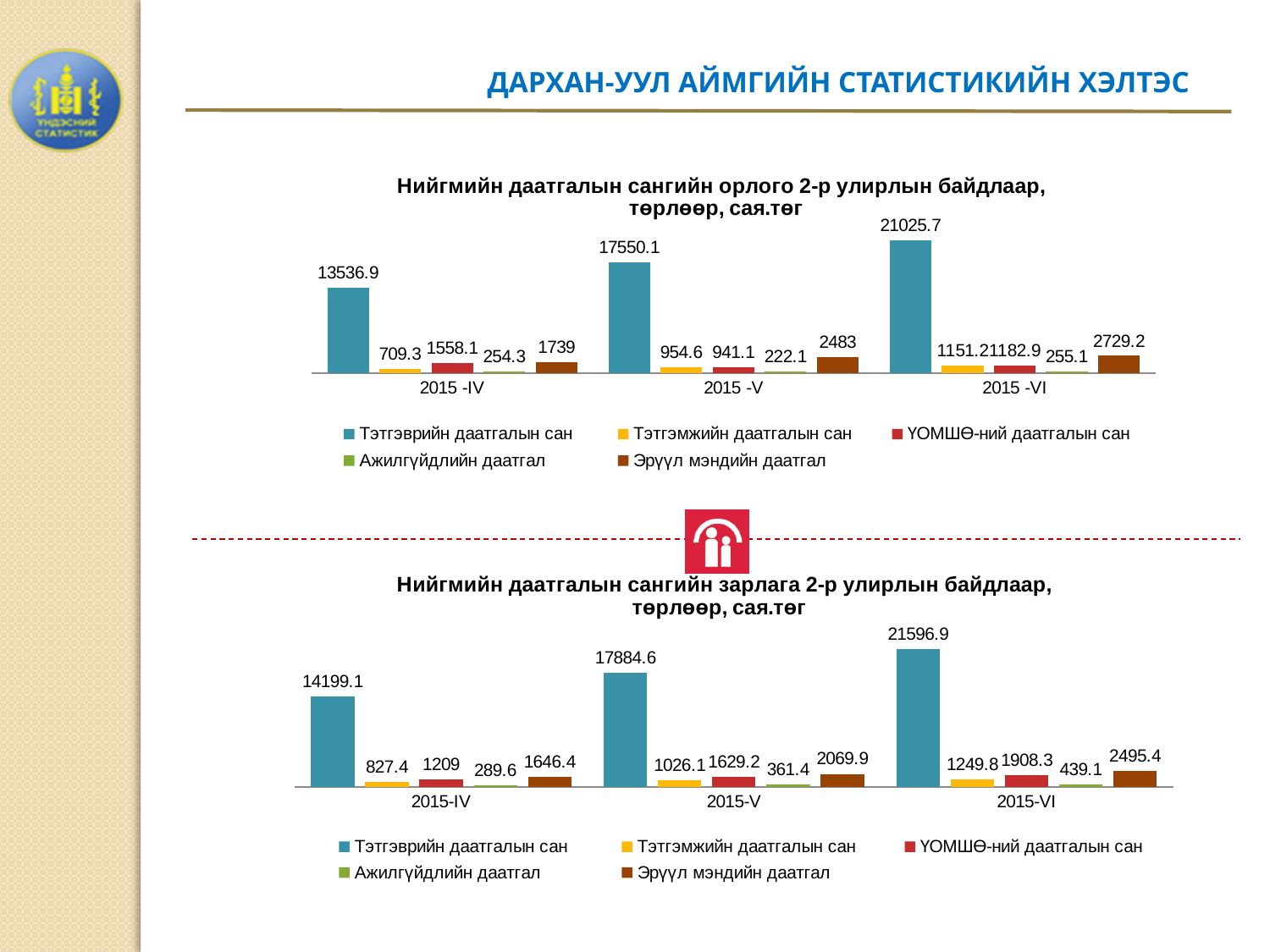
How many periods are shown on the x axis of the top chart (income)? 3 In the top chart (income), what is the value of Эрүүл мэндийн даатгал for 2015 -V? 2483 In the bottom chart (expenditure), what is the value of ҮОМШӨ-ний даатгалын сан for 2015-VI? 1908.3 In the top chart (income), what is the value of Тэтгэврийн даатгалын сан for 2015 -VI? 21025.7 What type of chart is the top chart (income)? Bar chart In the bottom chart (expenditure), does the value of Эрүүл мэндийн даатгал rise or fall from 2015-IV to 2015-VI? Rise In the bottom chart (expenditure), which period has the lowest value for Тэтгэмжийн даатгалын сан? 2015-IV In the bottom chart (expenditure), which is larger for 2015-V: Тэтгэмжийн даатгалын сан or ҮОМШӨ-ний даатгалын сан? ҮОМШӨ-ний даатгалын сан In the bottom chart (expenditure), what is the value of Ажилгүйдлийн даатгал for 2015-IV? 289.6 How many series does the legend of the bottom chart (expenditure) list? 5 In the top chart (income), which period has the highest value for Тэтгэврийн даатгалын сан? 2015 -VI In the top chart (income), what is the difference between Тэтгэврийн даатгалын сан in 2015 -VI and 2015 -IV? 7488.8